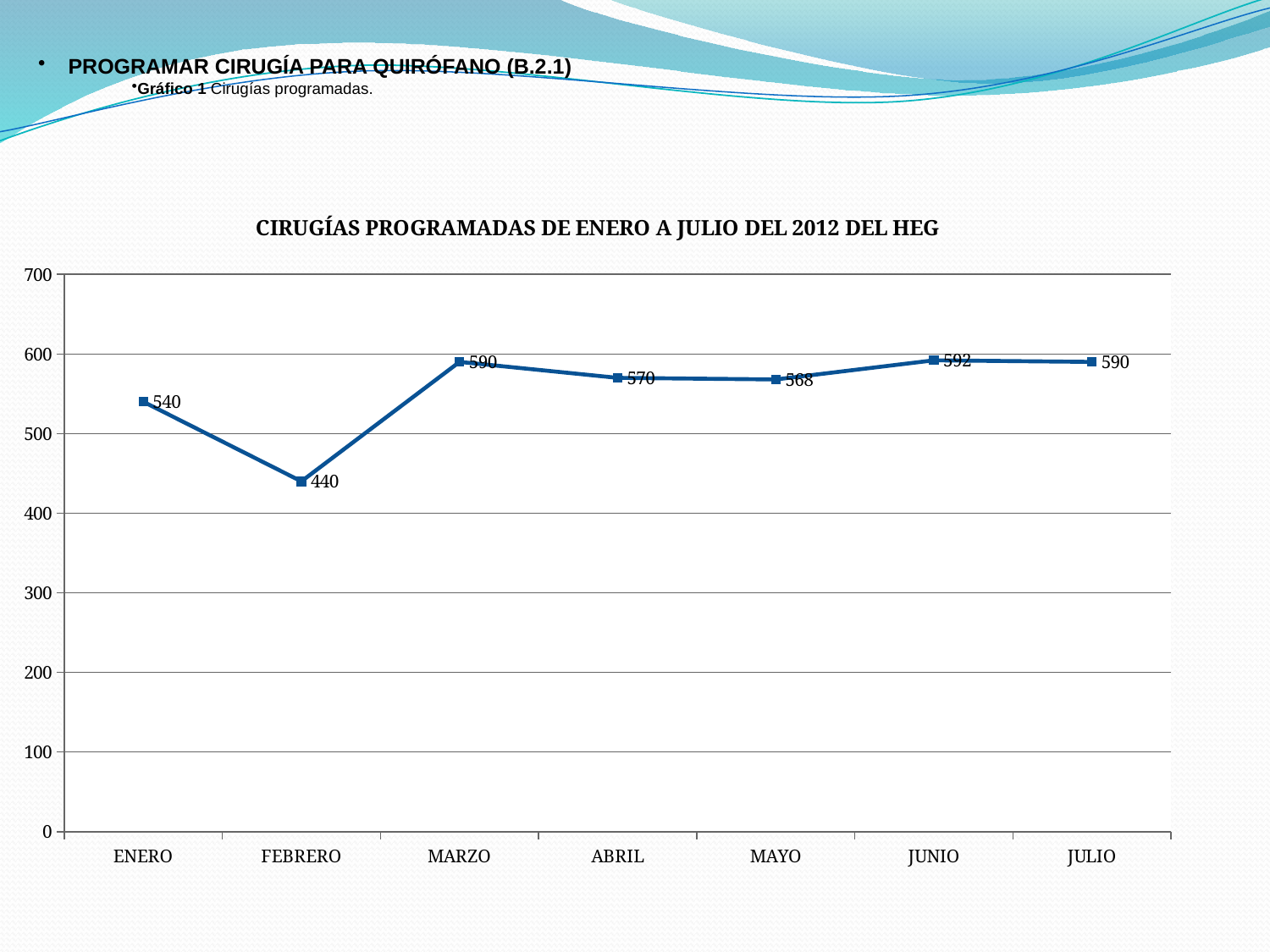
Is the value for FEBRERO greater or less than 500? less What is the title of the chart? CIRUGÍAS PROGRAMADAS DE ENERO A JULIO DEL 2012 DEL HEG Which month has the highest value? JUNIO What is the difference between the values for ENERO and JULIO? 50 Which month has the lowest value? FEBRERO What kind of chart is shown? line chart How many months are plotted on the chart? 7 What is the value for MAYO? 568 What is the difference between the values for MARZO and FEBRERO? 150 What is the value for FEBRERO? 440 Which is larger, the value for ENERO or the value for ABRIL? ABRIL What is the value for JUNIO? 592